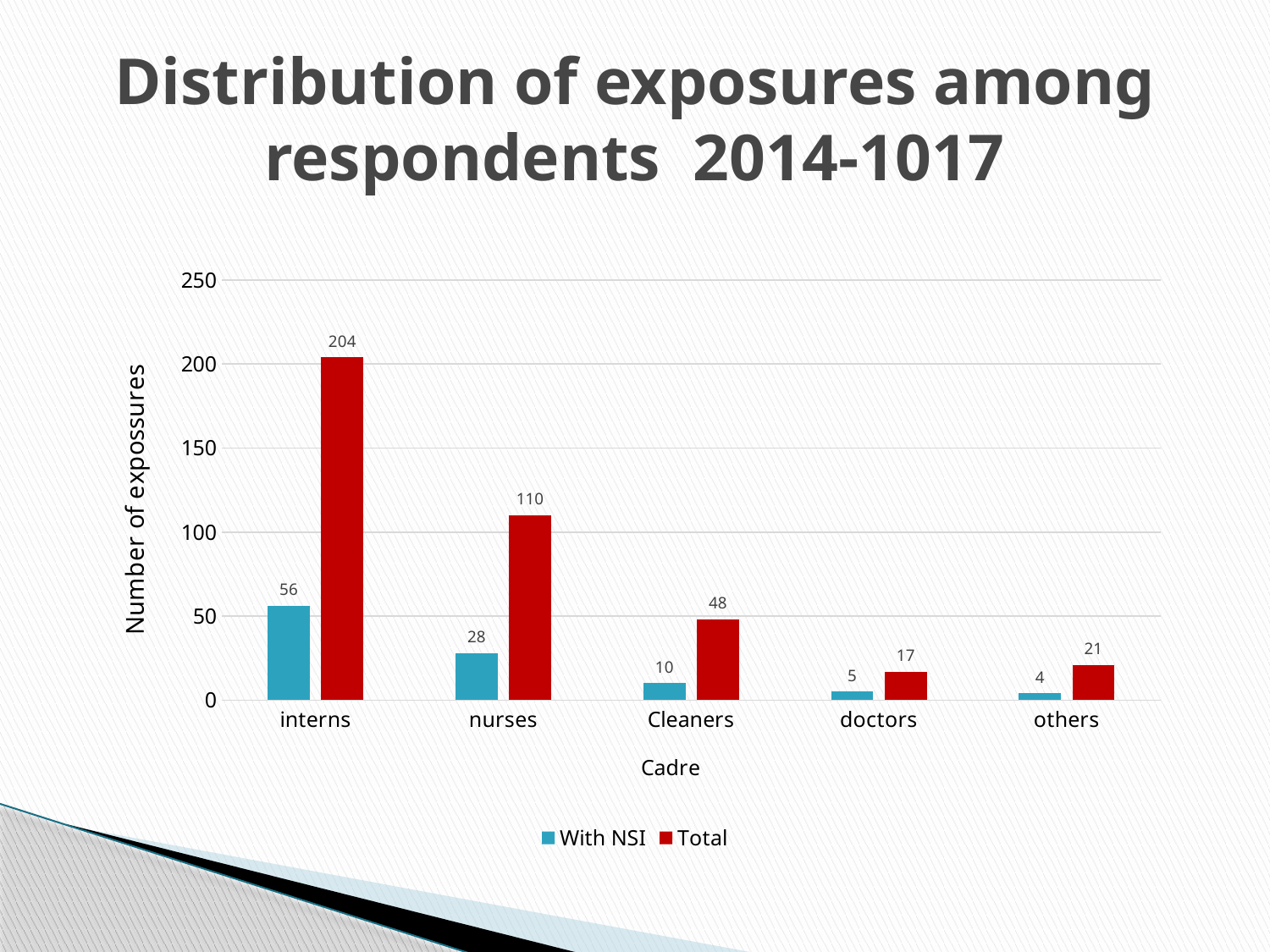
What is the label of the y axis? Number of expossures What is the With NSI value for nurses? 28 Which cadre has the highest Total value? interns What kind of chart is shown on the slide? bar chart How many series does the legend list? 2 What is the With NSI value for others? 4 What is the Total value for interns? 204 Which cadre has the lowest With NSI value? others Which is larger, the Total value for doctors or the Total value for others? others How many cadres are shown on the x axis? 5 What is the Total value for Cleaners? 48 What is the difference between the Total and With NSI values for nurses? 82